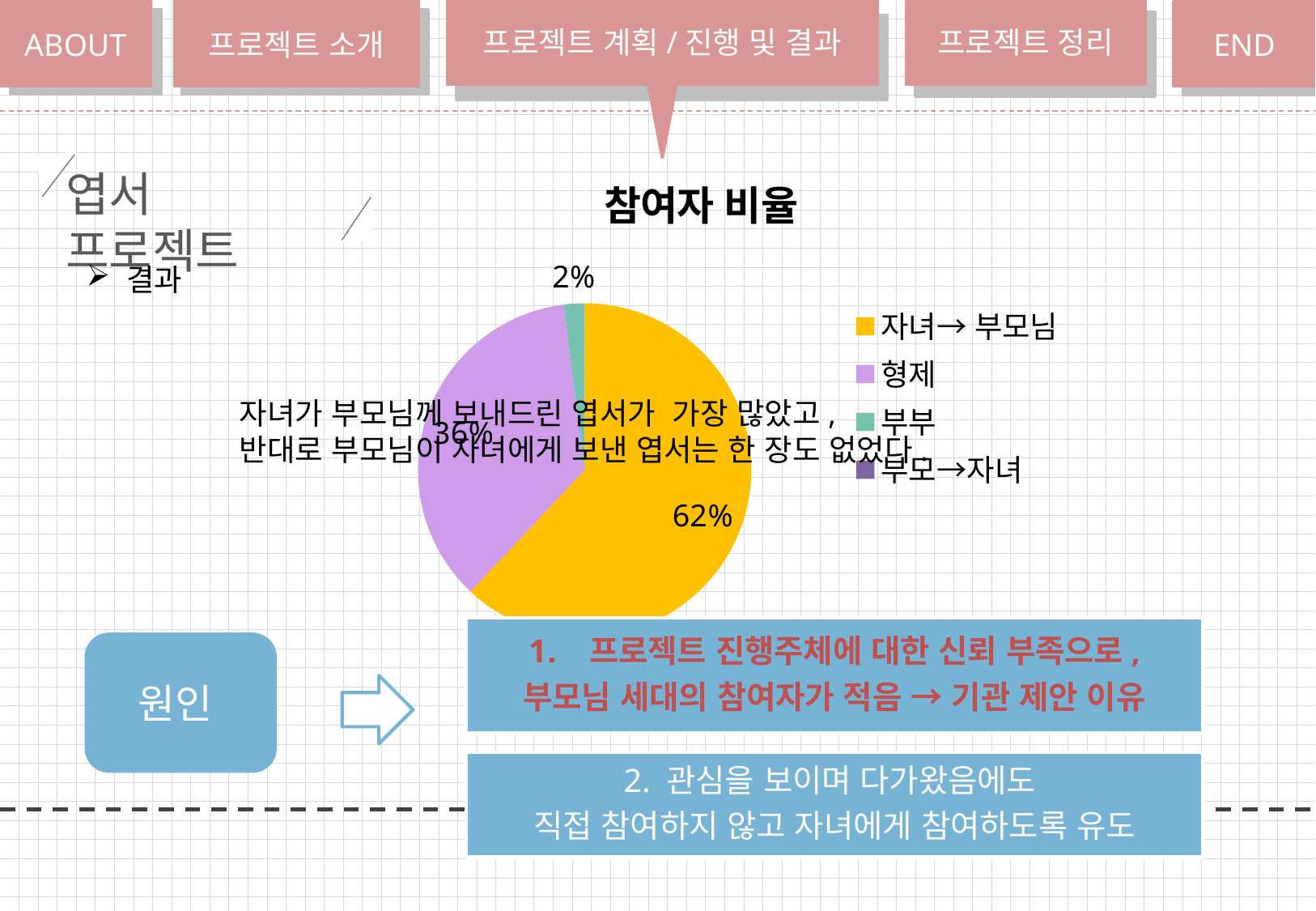
Is the share for 자녀→ 부모님 greater or less than 50%? greater Which category has the largest slice of the pie? 자녀→ 부모님 What is the difference in percentage points between the 자녀→ 부모님 slice and the 형제 slice? 26 What is the title of the chart? 참여자 비율 What share of the pie does 자녀→ 부모님 have? 62% What colour is the 형제 slice in the pie chart? purple What share of the pie does 부부 have? 2% How many entries does the chart's legend list? 4 Which category has the smallest visible slice of the pie? 부부 Which slice is larger, 형제 or 부부? 형제 What share of the pie does 형제 have? 36% What kind of chart is shown on the slide? pie chart